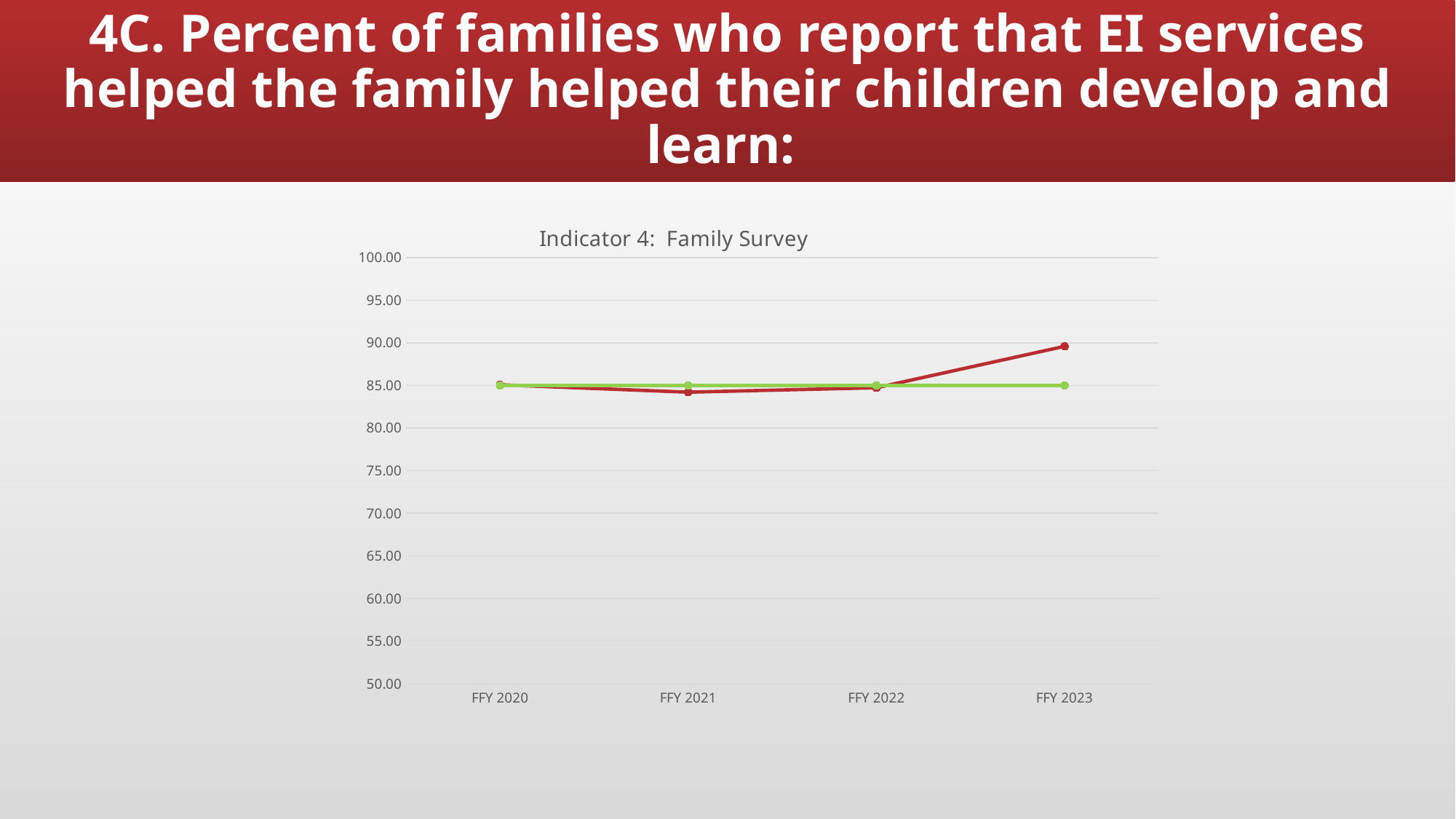
What is the value of the green line for FFY 2020? 85.00 What is the title of the chart? Indicator 4: Family Survey What is the lowest value shown on the y axis of the chart? 50.00 Is the value of the red line for FFY 2021 greater or less than 90.00? less In which fiscal year does the red line reach its highest value? FFY 2023 How many fiscal years are plotted along the x axis of the chart? 4 Is the value of the red line for FFY 2023 greater or less than 85.00? greater Does the red line rise or fall between FFY 2022 and FFY 2023? rise For FFY 2023, which line has the larger value, the red line or the green line? red line How many lines are plotted on the chart? 2 What kind of chart is shown on the slide? line chart